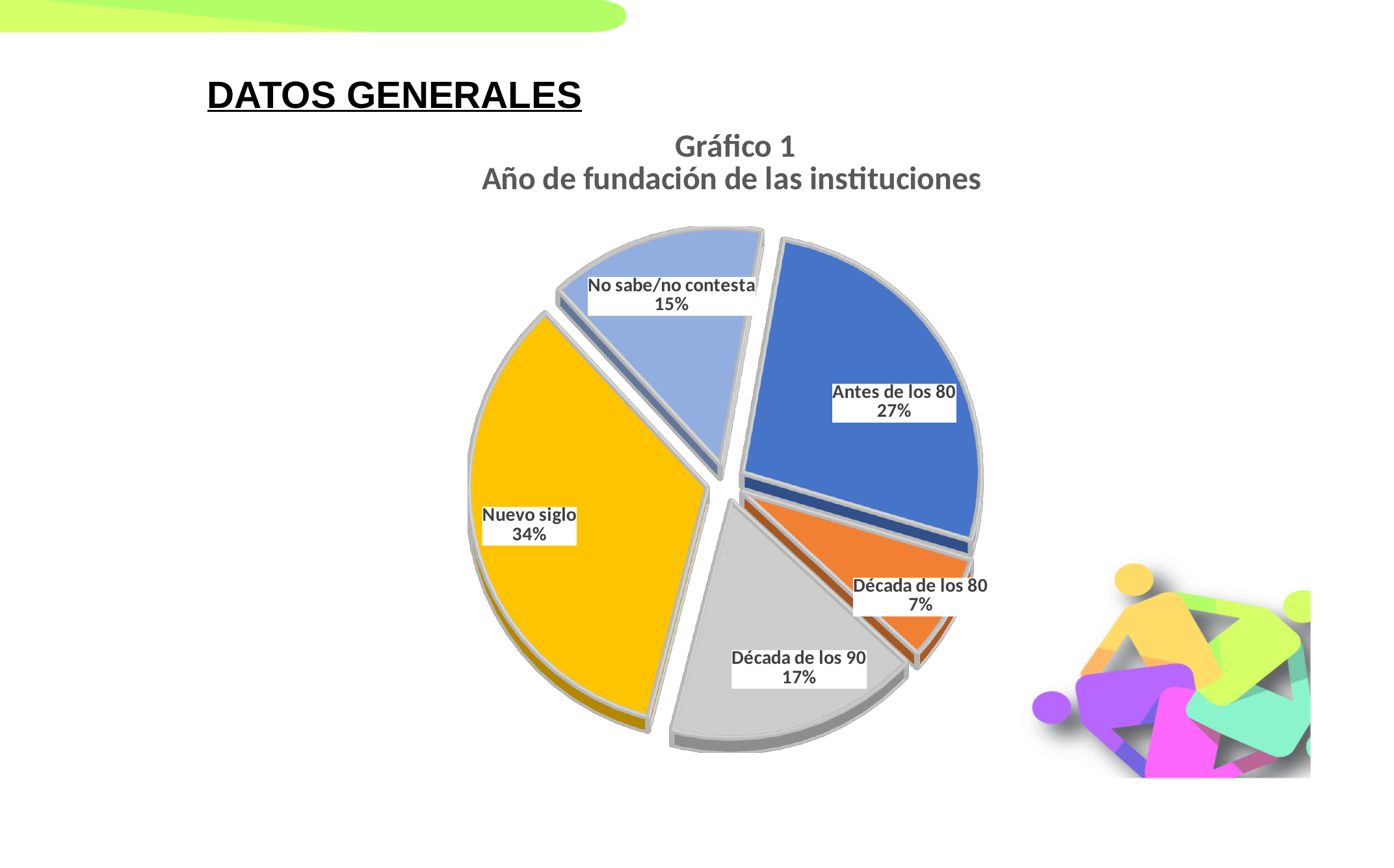
What percentage is shown for 'Antes de los 80'? 27% Which category has the smallest share of the pie? Década de los 80 What kind of chart is shown on the slide? pie chart What is the difference in percentage points between 'Nuevo siglo' and 'Antes de los 80'? 7 What is the title of the chart? Gráfico 1 Año de fundación de las instituciones How many slices does the pie chart have? 5 Which category has the largest share of the pie? Nuevo siglo Which is larger, 'Década de los 90' or 'No sabe/no contesta'? Década de los 90 What colour is the 'Nuevo siglo' slice? yellow What percentage is shown for 'No sabe/no contesta'? 15% What percentage is shown for 'Década de los 90'? 17% What percentage of institutions were founded in the 'Nuevo siglo'? 34%